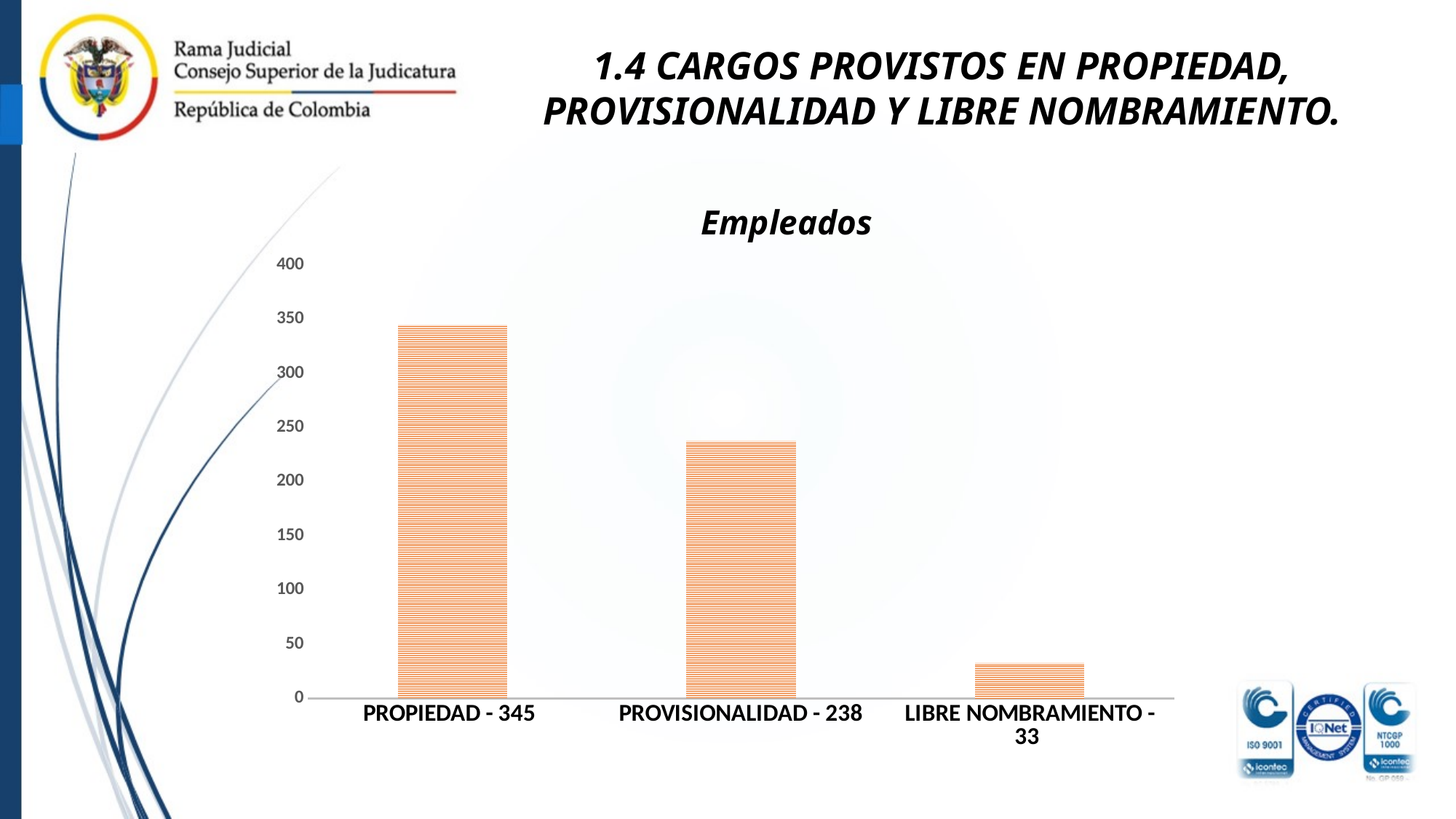
What kind of chart is shown on the slide? bar chart How many categories are shown in the Empleados chart? 3 What is the difference between the values for PROPIEDAD and PROVISIONALIDAD? 107 What is the value for PROPIEDAD in the Empleados chart? 345 Which category has the highest value in the Empleados chart? PROPIEDAD Is the value for PROVISIONALIDAD greater or less than 250? less Which category has the lowest value in the Empleados chart? LIBRE NOMBRAMIENTO What is the value for LIBRE NOMBRAMIENTO in the Empleados chart? 33 Which is larger, the value for PROVISIONALIDAD or the value for LIBRE NOMBRAMIENTO? PROVISIONALIDAD What is the difference between the values for PROVISIONALIDAD and LIBRE NOMBRAMIENTO? 205 What is the title of the chart on the slide? Empleados What is the value for PROVISIONALIDAD in the Empleados chart? 238